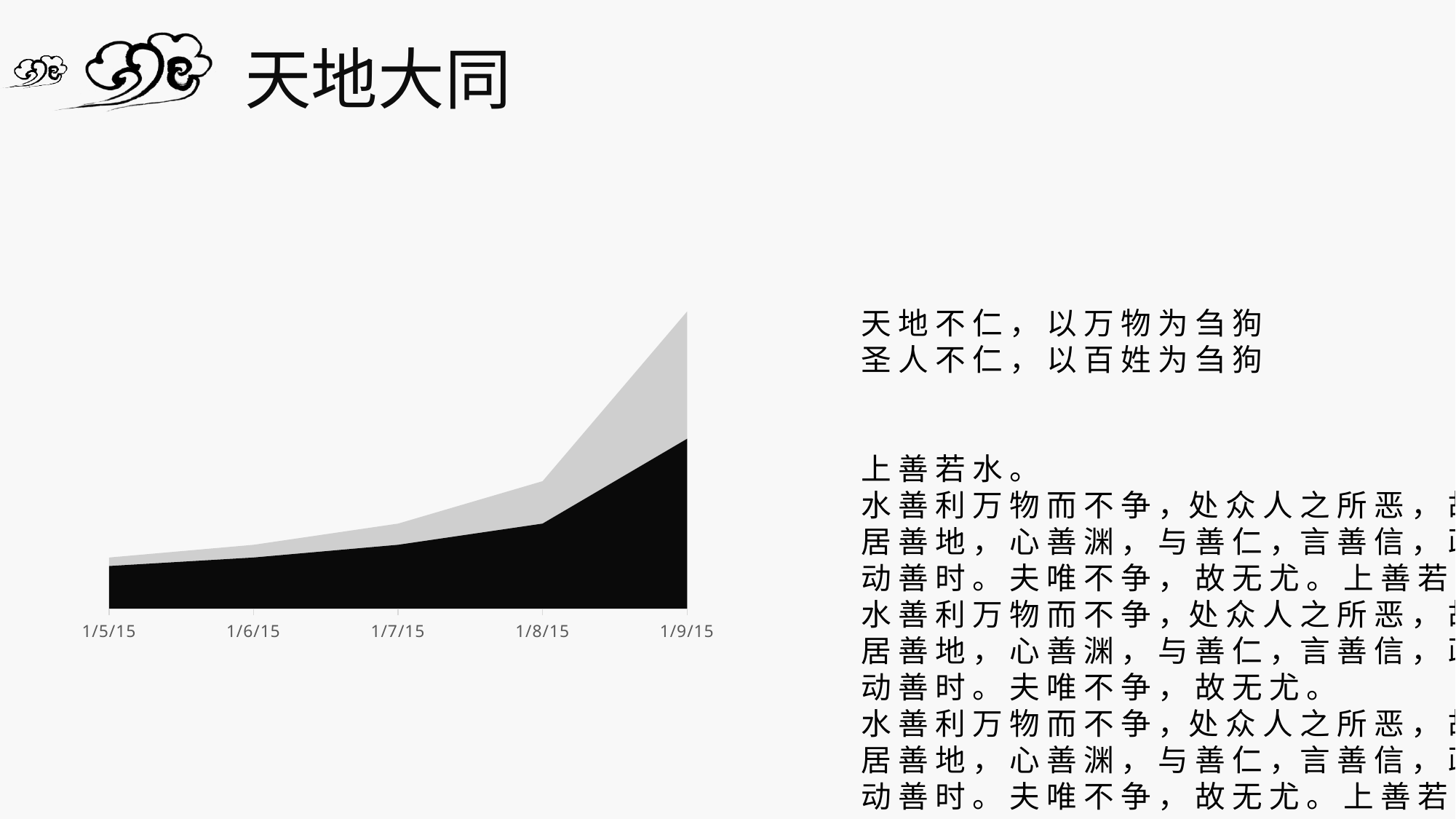
How many stacked series are plotted in the chart? 2 What kind of chart is shown on the slide? area chart What is the first date shown on the x axis of the chart? 1/5/15 At which date does the chart have its lowest total value? 1/5/15 Which date has the larger total value in the chart, 1/6/15 or 1/7/15? 1/7/15 Which date has the larger total value in the chart, 1/8/15 or 1/9/15? 1/9/15 At which date does the chart reach its highest total value? 1/9/15 What colour is the bottom series in the chart? black Between which two consecutive dates does the chart show the steepest increase? 1/8/15 and 1/9/15 How many dates are shown on the x axis of the chart? 5 What is the last date shown on the x axis of the chart? 1/9/15 Do the values in the chart rise or fall from 1/5/15 to 1/9/15? rise